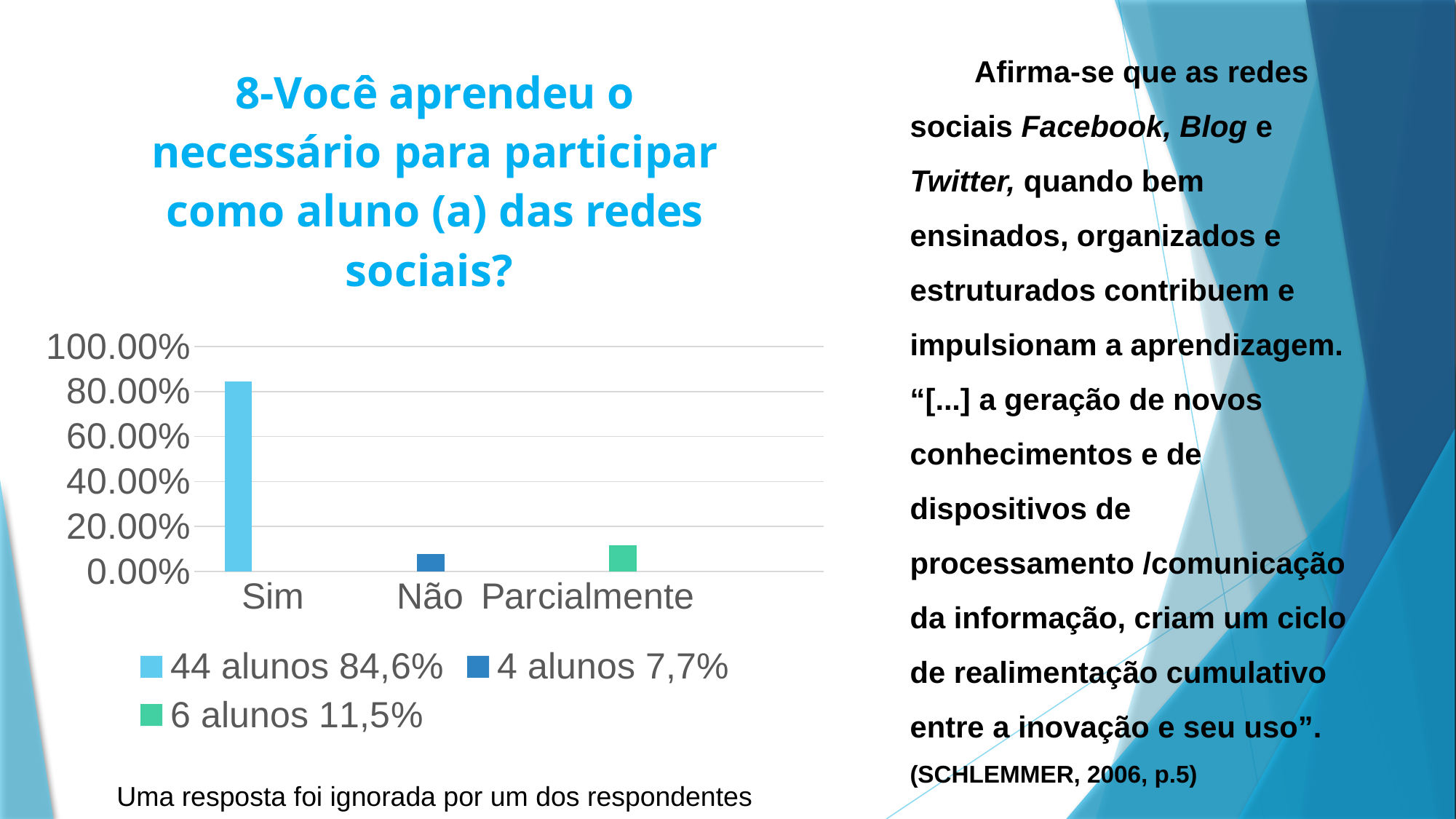
Is the value for Não greater or less than 20.00%? less Is the value for Parcialmente greater or less than 20.00%? less Which category has the highest bar in the chart? Sim Which category has the lowest bar in the chart? Não How many entries does the chart's legend list? 3 Which is larger, the bar for Parcialmente or the bar for Não? Parcialmente According to the legend, what percentage corresponds to the light blue series (Sim)? 84,6% Is the value for Sim greater or less than 80.00%? greater What kind of chart is shown on the slide? bar chart What is the highest tick value shown on the chart's y axis? 100.00% How many categories are shown on the x axis of the chart? 3 According to the legend, how many students (alunos) are in the green series (Parcialmente)? 6 alunos